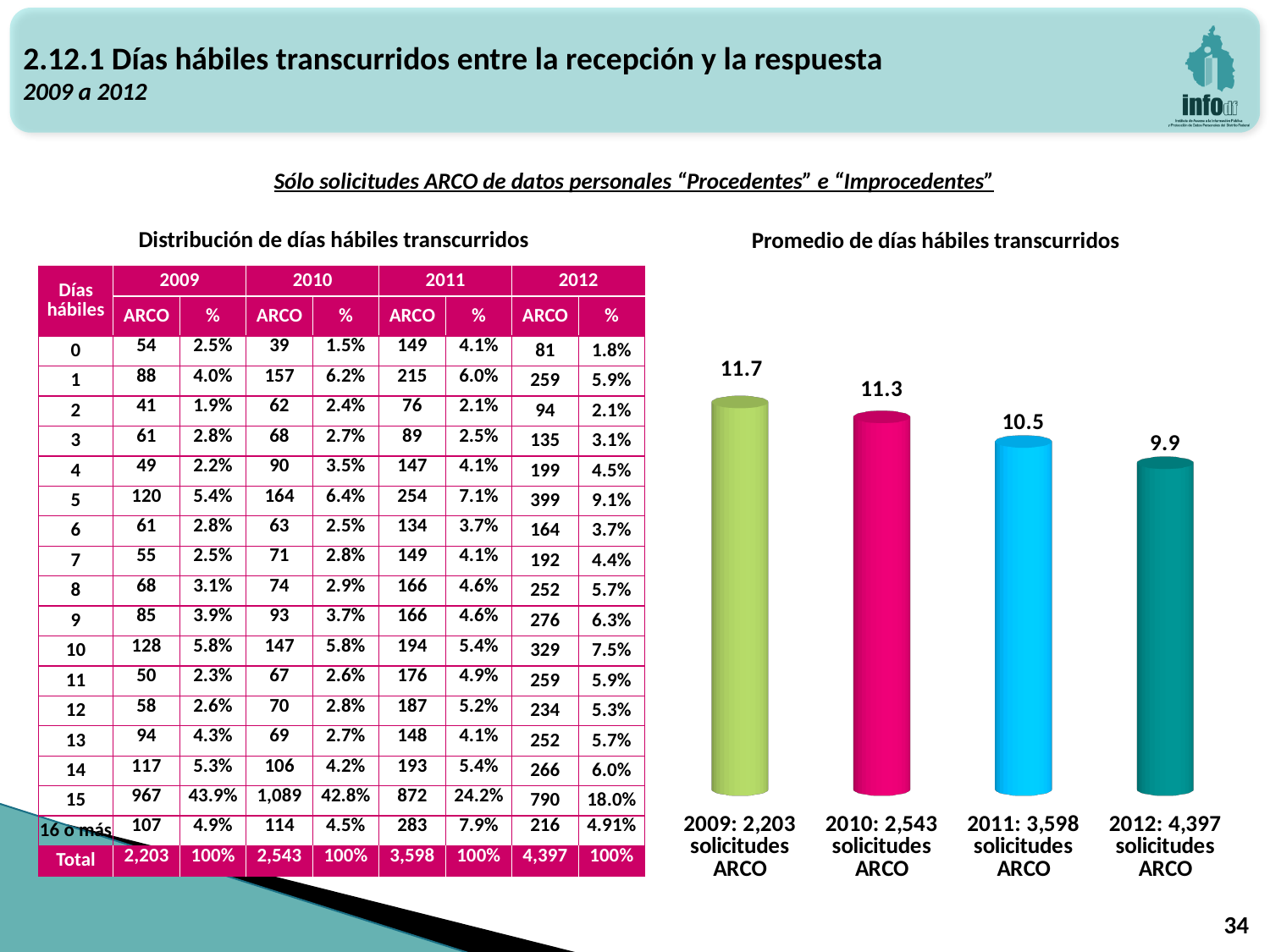
In the chart 'Promedio de días hábiles transcurridos', what is the value for 2010? 11.3 What kind of chart is 'Promedio de días hábiles transcurridos'? Bar chart In the chart 'Promedio de días hábiles transcurridos', what is the value for 2009? 11.7 In the chart 'Promedio de días hábiles transcurridos', which year has the lowest value? 2012 In the chart 'Promedio de días hábiles transcurridos', which is larger, the value for 2010 or the value for 2011? 2010 In the chart 'Promedio de días hábiles transcurridos', what is the value for 2011? 10.5 In the chart 'Promedio de días hábiles transcurridos', what is the difference between the values for 2009 and 2012? 1.8 How many bars are shown in the chart 'Promedio de días hábiles transcurridos'? 4 In the chart 'Promedio de días hábiles transcurridos', which year has the highest value? 2009 In the chart 'Promedio de días hábiles transcurridos', how many solicitudes ARCO are stated in the label for 2011? 3,598 In the chart 'Promedio de días hábiles transcurridos', do the values rise or fall from 2009 to 2012? Fall In the chart 'Promedio de días hábiles transcurridos', what is the value for 2012? 9.9